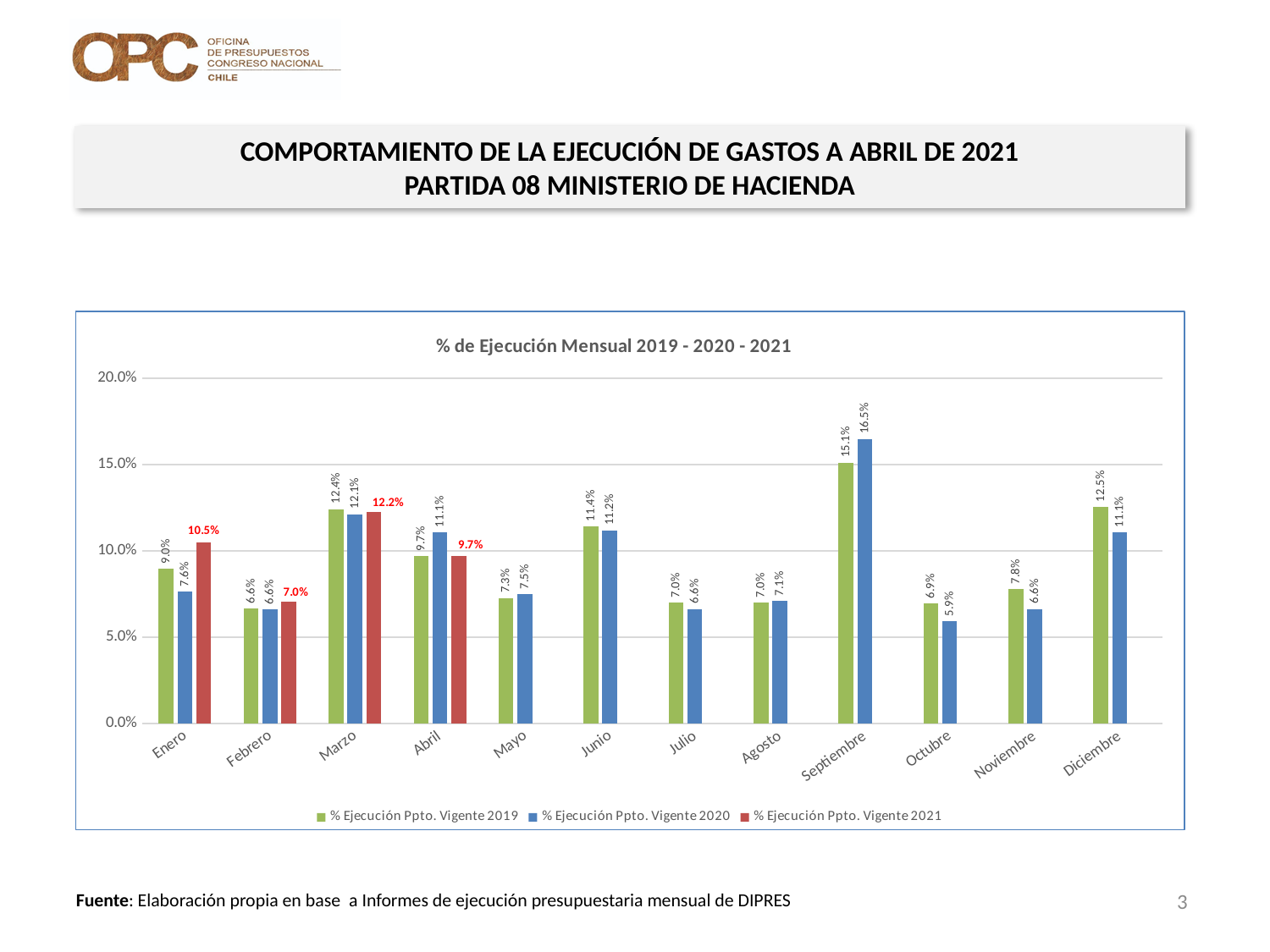
What is the difference between the 2021 and 2020 values for Enero? 2.9% Is the % Ejecución Ppto. Vigente 2019 value for Septiembre greater or less than 15.0%? greater Which month has the highest % Ejecución Ppto. Vigente 2020 value? Septiembre What is the % Ejecución Ppto. Vigente 2020 value for Septiembre? 16.5% Which is larger for Abril: the % Ejecución Ppto. Vigente 2020 value or the 2021 value? % Ejecución Ppto. Vigente 2020 What is the title of the chart? % de Ejecución Mensual 2019 - 2020 - 2021 What is the % Ejecución Ppto. Vigente 2021 value for Marzo? 12.2% How many series does the legend list? 3 What kind of chart is shown on the slide? Bar chart Which month has the lowest % Ejecución Ppto. Vigente 2020 value? Octubre What is the % Ejecución Ppto. Vigente 2019 value for Diciembre? 12.5% How many months are shown on the x axis? 12